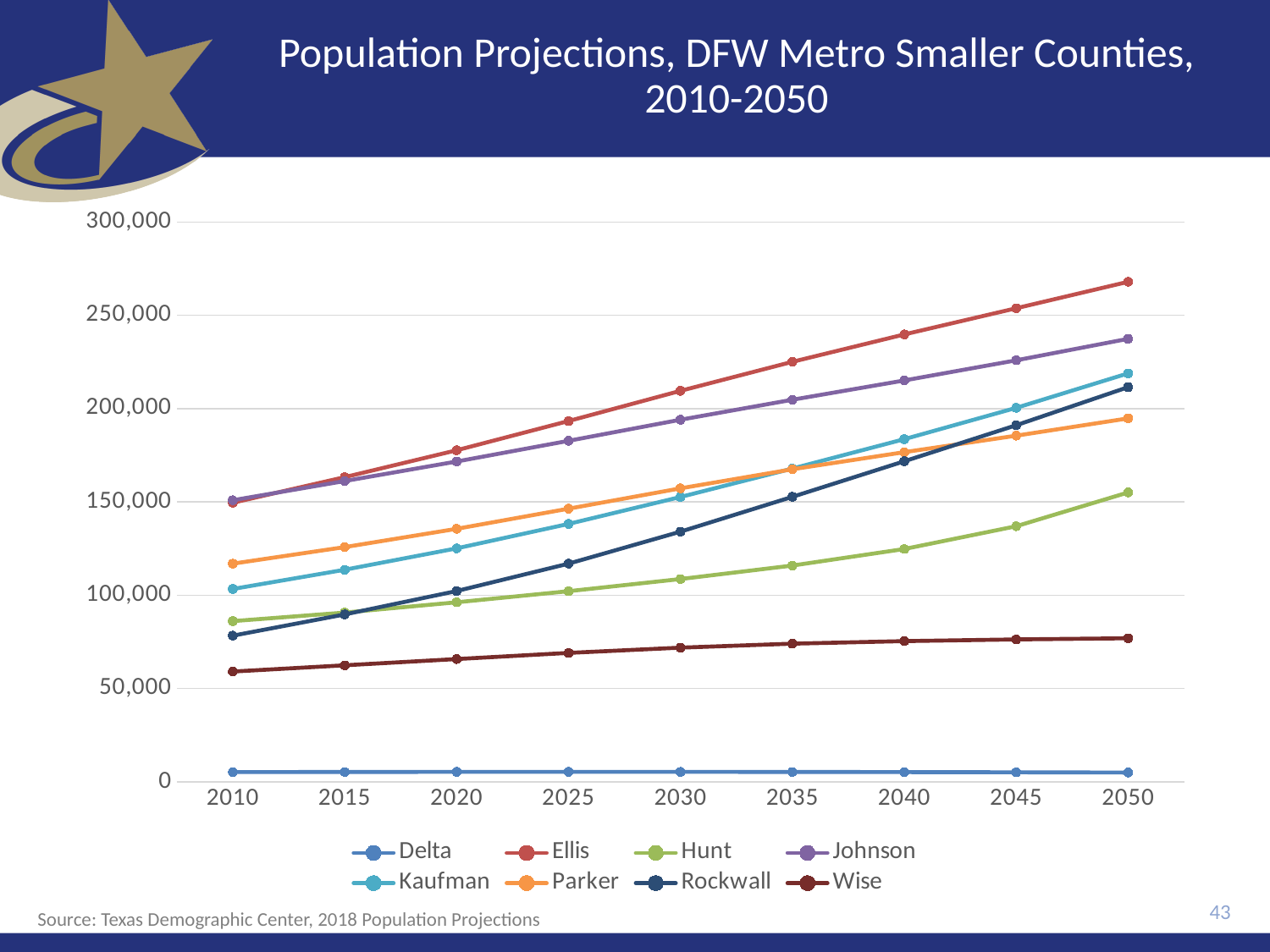
In 2050, which is larger, the value for Kaufman or the value for Parker? Kaufman Which county has the lowest projected population in 2050? Delta What is the title of the chart? Population Projections, DFW Metro Smaller Counties, 2010-2050 Which county has the highest projected population in 2050? Ellis Does the Ellis line rise or fall from 2010 to 2050? rise Is the value for Rockwall in 2010 greater or less than 100,000? less Is the value for Ellis in 2050 greater or less than 250,000? greater Is the value for Wise in 2050 greater or less than 100,000? less How many years are plotted along the x axis? 9 How many series does the legend list? 8 What kind of chart is shown on the slide? line chart